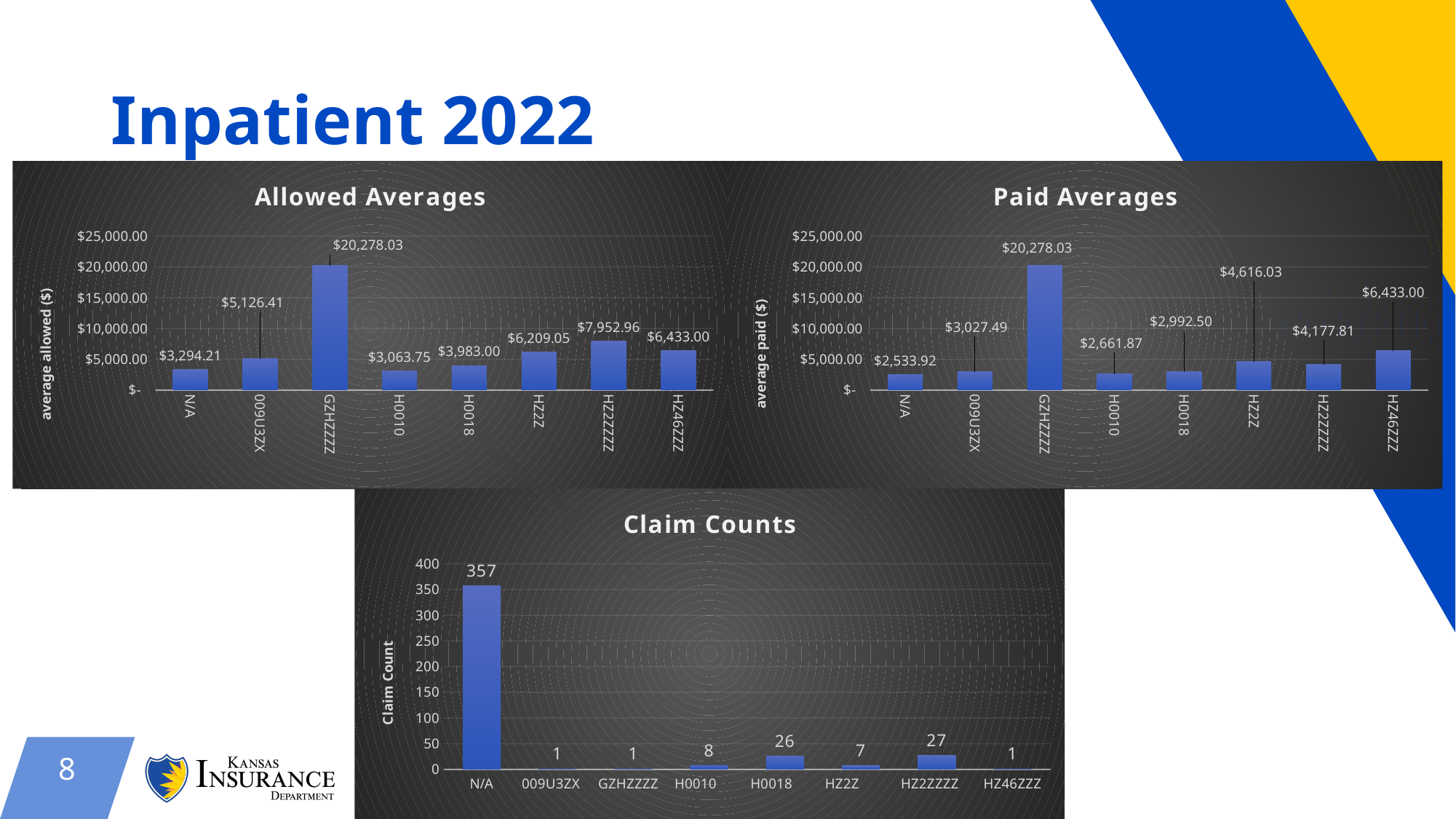
What type of chart is the Paid Averages chart? bar chart In the Allowed Averages chart, what is the average allowed for GZHZZZZ? $20,278.03 In the Claim Counts chart, what is the difference between the claim counts for N/A and HZ2ZZZZ? 330 How many categories are shown on the x axis of the Claim Counts chart? 8 In the Allowed Averages chart, what is the difference between the values for HZ2ZZZZ and HZ2Z? $1,743.91 In the Claim Counts chart, which category has the highest claim count? N/A In the Paid Averages chart, which category has the lowest average paid? N/A In the Paid Averages chart, which is larger, the value for HZ46ZZZ or the value for HZ2ZZZZ? HZ46ZZZ In the Allowed Averages chart, which category has the lowest average allowed? H0010 In the Paid Averages chart, what is the average paid for HZ2Z? $4,616.03 In the Claim Counts chart, how many claims are shown for H0018? 26 In the Allowed Averages chart, is the value for 009U3ZX greater or less than $10,000.00? less